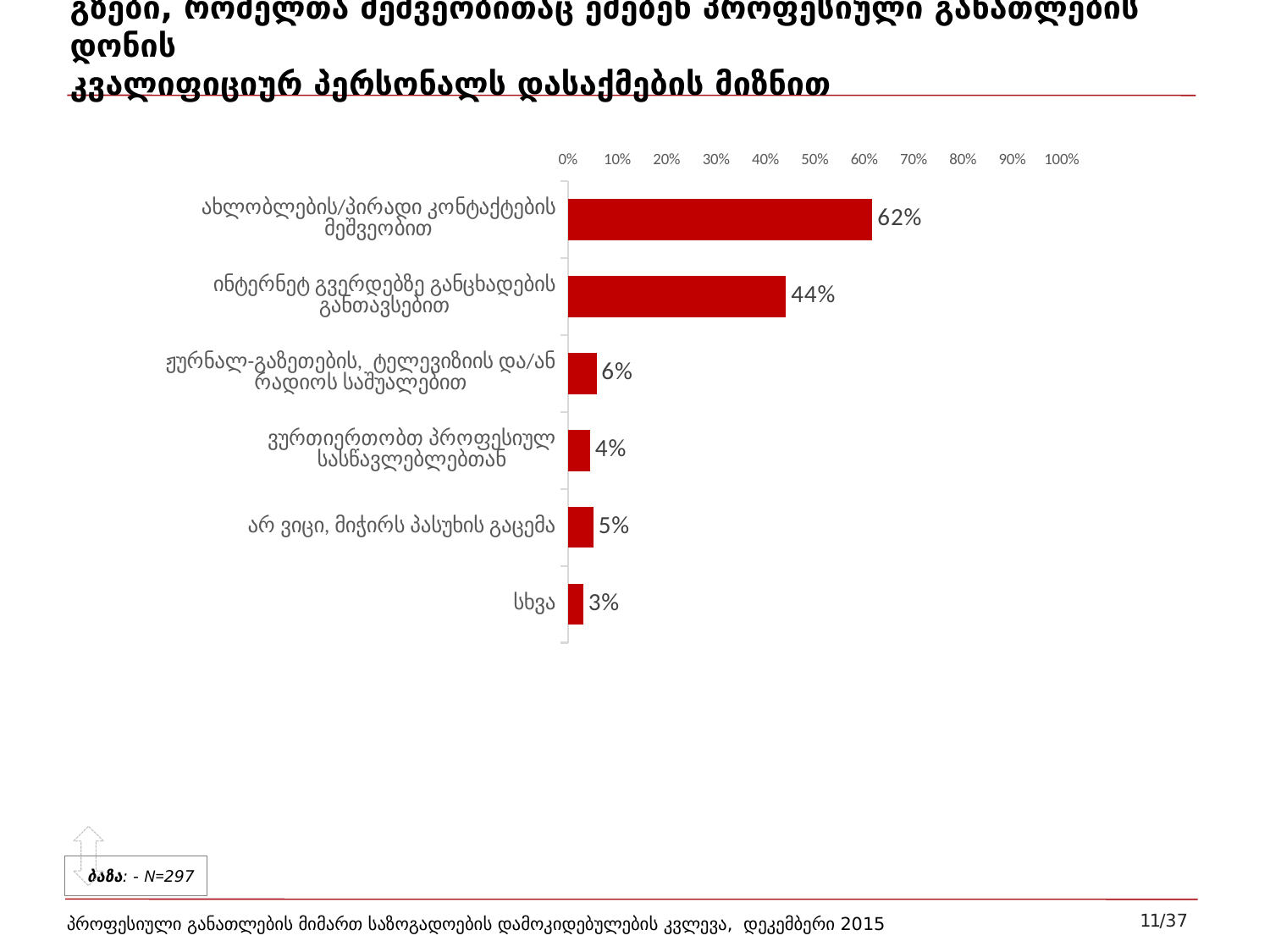
Which category has the highest value? ახლობლების/პირადი კონტაქტების მეშვეობით What is the value for "სხვა"? 3% Which category has the lowest value? სხვა Which is larger: the value for "არ ვიცი, მიჭირს პასუხის გაცემა" or the value for "ვურთიერთობთ პროფესიულ სასწავლებლებთან"? არ ვიცი, მიჭირს პასუხის გაცემა What kind of chart is shown on the slide? bar chart What is the value for "ჟურნალ-გაზეთების, ტელევიზიის და/ან რადიოს საშუალებით"? 6% What is the value for "ახლობლების/პირადი კონტაქტების მეშვეობით"? 62% How many categories are shown in the chart? 6 What is the value for "ინტერნეტ გვერდებზე განცხადების განთავსებით"? 44% Is the value for "ინტერნეტ გვერდებზე განცხადების განთავსებით" greater or less than 50%? less What is the base (N) stated for the chart? N=297 What is the difference between the values for "ახლობლების/პირადი კონტაქტების მეშვეობით" and "ინტერნეტ გვერდებზე განცხადების განთავსებით"? 18%